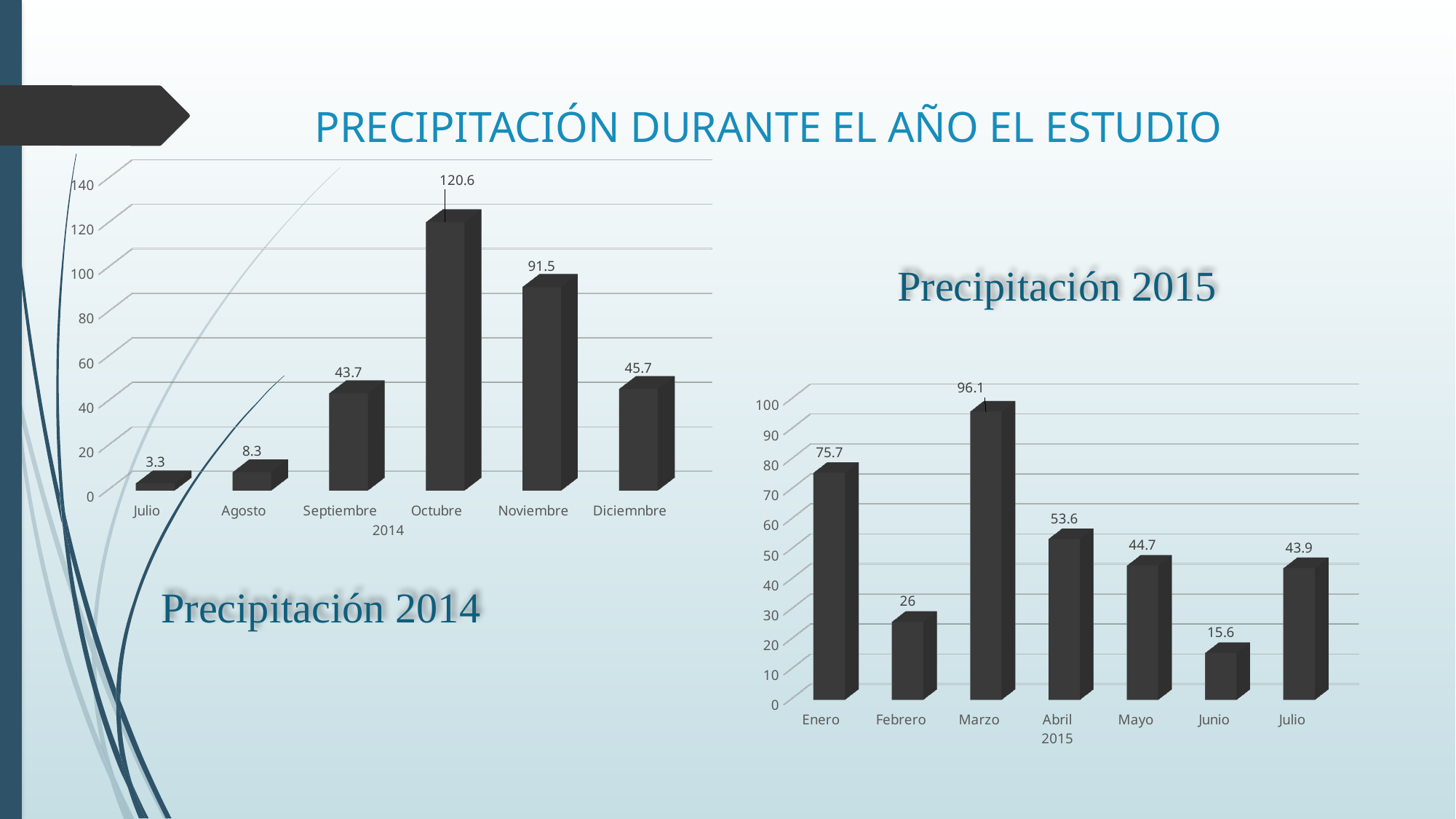
In the Precipitación 2014 chart, is the value for Septiembre greater or less than 40? greater What is the title of the slide? PRECIPITACIÓN DURANTE EL AÑO EL ESTUDIO In the Precipitación 2014 chart, what is the difference between Noviembre and Diciemnbre? 45.8 In the Precipitación 2014 chart, which month has the lowest value? Julio In the Precipitación 2014 chart, how many months are plotted? 6 In the Precipitación 2014 chart, what is the value for Octubre? 120.6 What kind of chart is the Precipitación 2015 chart? Bar chart In the Precipitación 2015 chart, which is larger, Abril or Mayo? Abril In the Precipitación 2015 chart, what is the value for Febrero? 26 In the Precipitación 2015 chart, how many months are plotted? 7 In the Precipitación 2015 chart, what is the difference between Enero and Junio? 60.1 In the Precipitación 2015 chart, which month has the highest value? Marzo